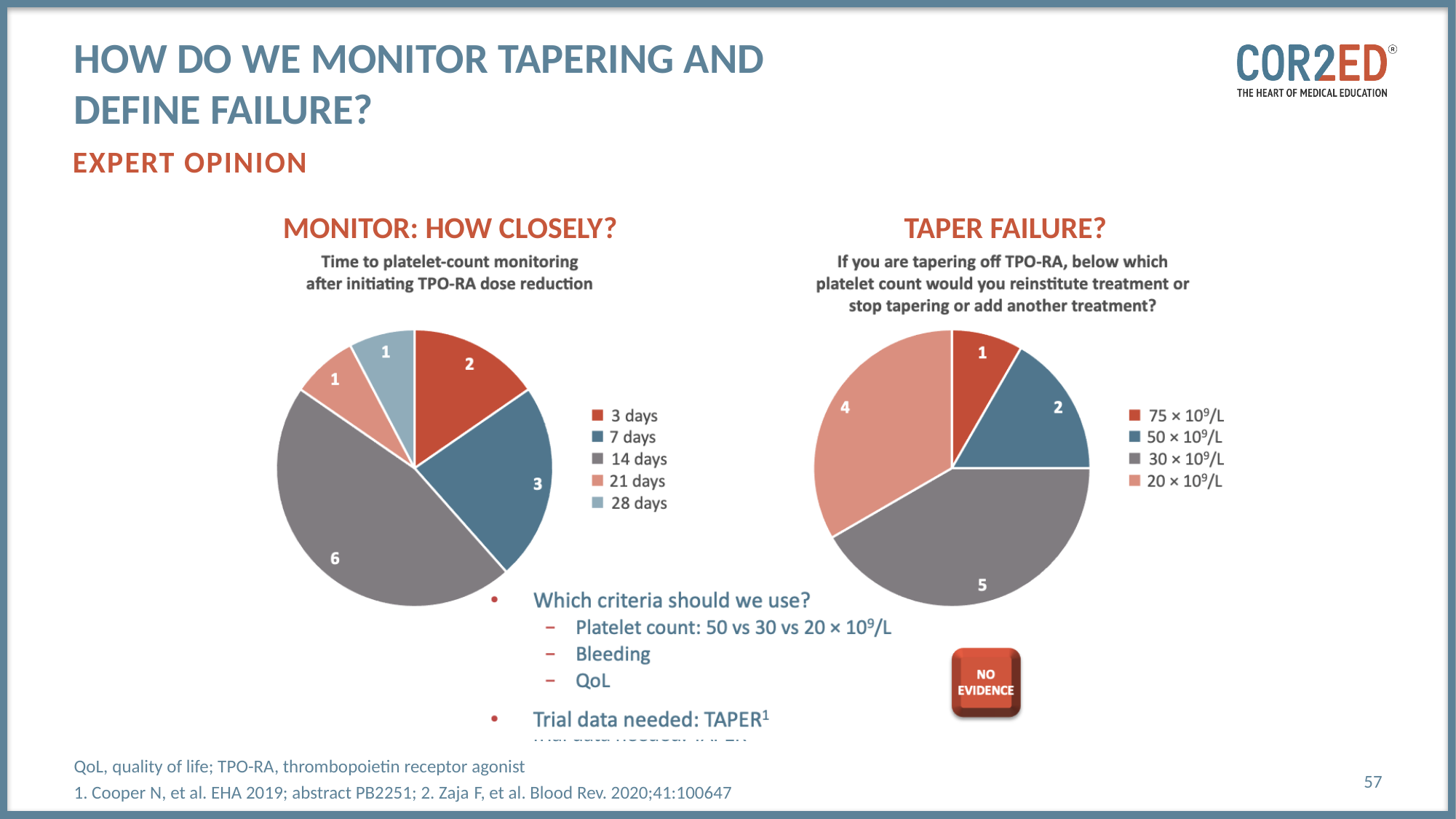
In the 'Taper failure' pie chart on the right, what is the difference between the values for 20 × 10⁹/L and 50 × 10⁹/L? 2 What kind of chart is used in the 'Time to platelet-count monitoring after initiating TPO-RA dose reduction' chart? Pie chart In the 'Time to platelet-count monitoring after initiating TPO-RA dose reduction' pie chart, how many categories does the legend list? 5 In the 'Time to platelet-count monitoring after initiating TPO-RA dose reduction' pie chart, which category has the largest slice? 14 days In the 'Taper failure' pie chart on the right, what is the total of all slices? 12 In the 'Time to platelet-count monitoring after initiating TPO-RA dose reduction' pie chart, what is the value for 14 days? 6 In the 'Time to platelet-count monitoring after initiating TPO-RA dose reduction' pie chart, what is the total of all slices? 13 In the 'Time to platelet-count monitoring after initiating TPO-RA dose reduction' pie chart, which is larger, the value for 3 days or the value for 7 days? 7 days In the 'Taper failure' pie chart on the right, which category has the smallest slice? 75 × 10⁹/L In the 'Time to platelet-count monitoring after initiating TPO-RA dose reduction' pie chart, what is the difference between the values for 14 days and 3 days? 4 In the 'Time to platelet-count monitoring after initiating TPO-RA dose reduction' pie chart, what is the value for 7 days? 3 In the 'Taper failure' pie chart on the right, what is the value for 30 × 10⁹/L? 5